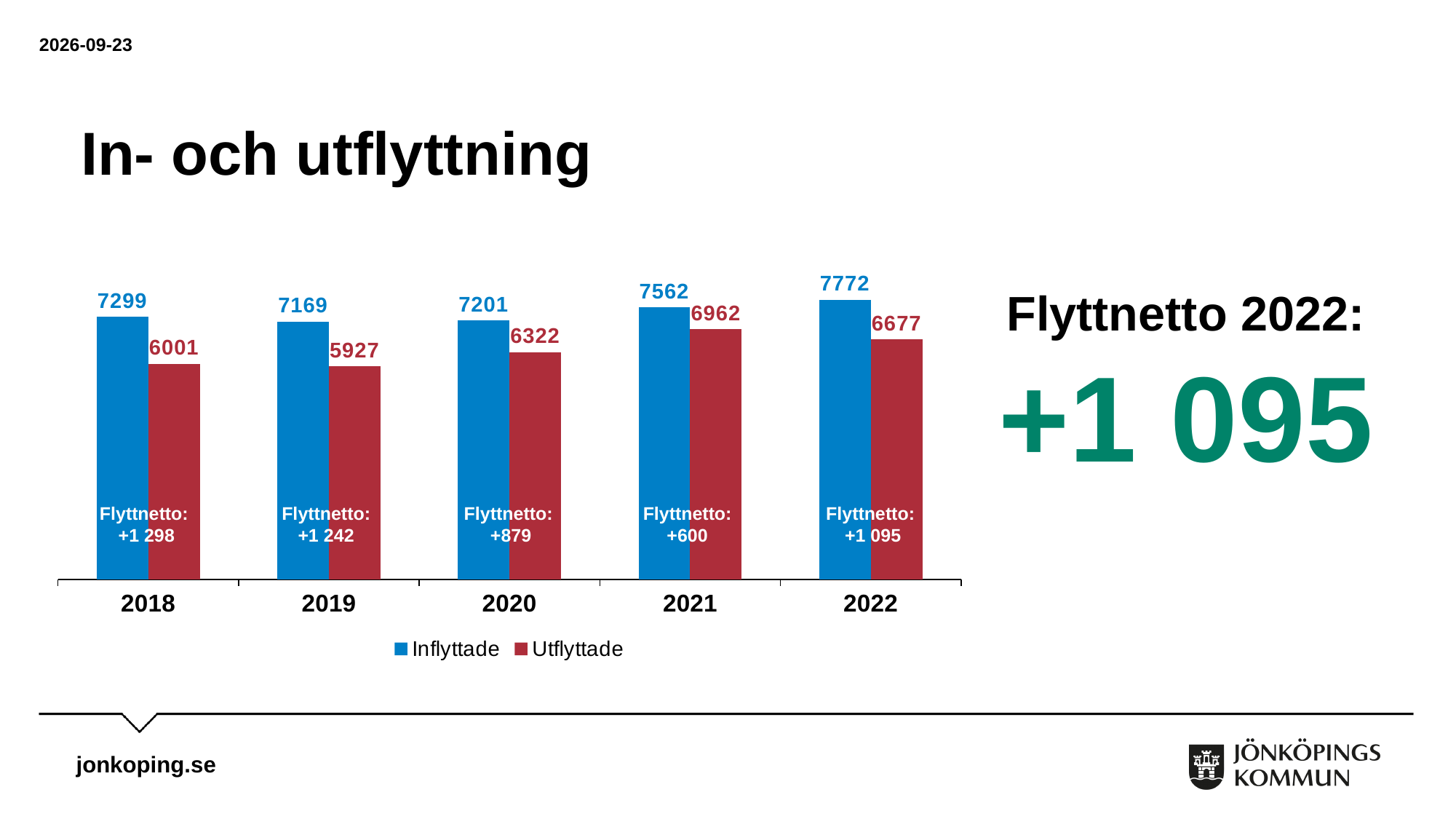
What is the difference between Inflyttade and Utflyttade in 2020? 879 Which year has the highest value for Inflyttade? 2022 How many series does the legend list? 2 Which year has the lowest value for Inflyttade? 2019 What kind of chart is shown on the slide? Bar chart What is the value for Utflyttade in 2021? 6962 Which year has the lowest value for Utflyttade? 2019 Which is larger: Utflyttade in 2021 or Utflyttade in 2022? Utflyttade in 2021 What is the value for Utflyttade in 2019? 5927 How many years are shown on the x axis? 5 What is the Flyttnetto shown for 2021? +600 What is the value for Inflyttade in 2022? 7772